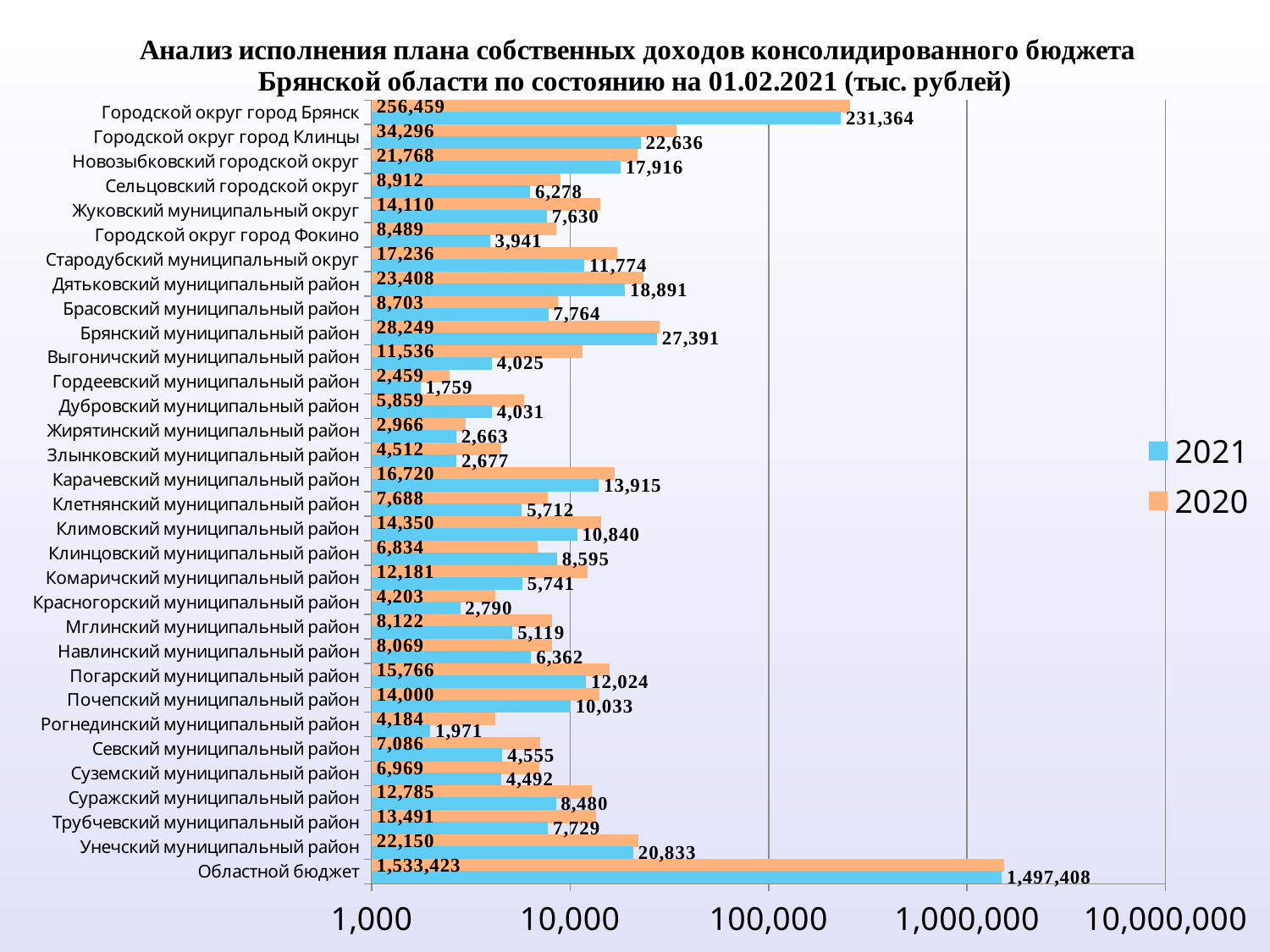
Which category has the lowest 2021 value? Гордеевский муниципальный район Which category has the highest 2021 value? Областной бюджет What colour represents the 2020 series? Orange How many series does the legend list? 2 For Клинцовский муниципальный район, which year has the larger value, 2020 or 2021? 2021 What is the difference between the 2020 and 2021 values for Областной бюджет? 36,015 What is the 2021 value for Почепский муниципальный район? 10,033 What kind of chart is shown on the slide? Bar chart How many categories are shown on the chart? 32 What is the 2020 value for Унечский муниципальный район? 22,150 What is the 2021 value for Городской округ город Брянск? 231,364 What is the difference between the 2020 and 2021 values for Городской округ город Брянск? 25,095